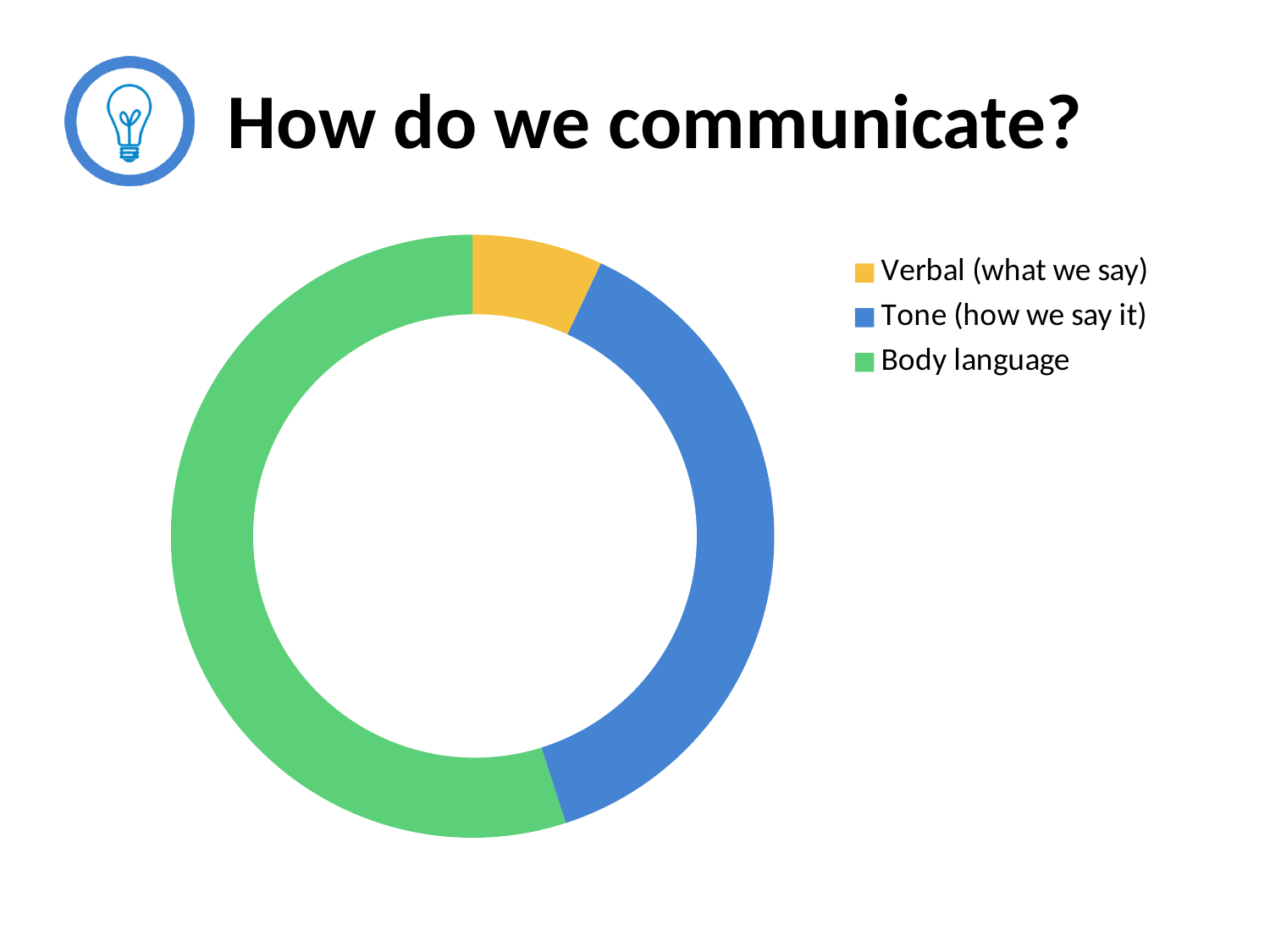
Is the share for Verbal (what we say) greater or less than 25%? less Which category has the smallest share of the chart? Verbal (what we say) What kind of chart is shown on the slide? doughnut chart Which is larger, the share for Body language or the share for Tone (how we say it)? Body language Which category has the largest share of the chart? Body language Is the share for Body language greater or less than 50%? greater How many entries does the legend list? 3 What colour represents Tone (how we say it) in the chart? blue How many categories does the chart show? 3 What is the title of the slide containing the chart? How do we communicate? Which is larger, the share for Tone (how we say it) or the share for Verbal (what we say)? Tone (how we say it)